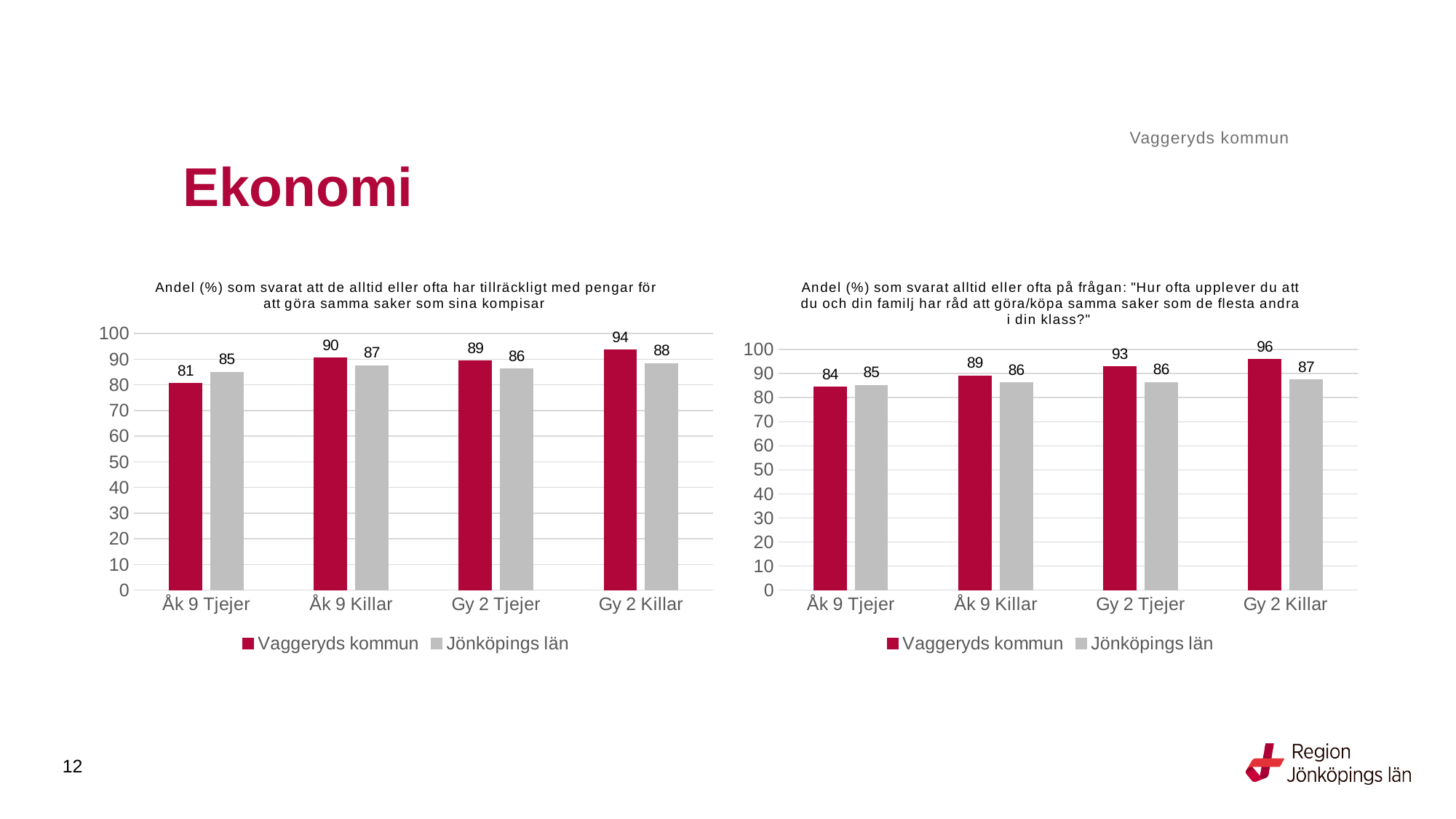
In the left chart, what is the difference between Vaggeryds kommun and Jönköpings län for Gy 2 Killar? 6 In the right chart, what is the value for Jönköpings län for Åk 9 Killar? 86 In the left chart, which category has the highest value for Vaggeryds kommun? Gy 2 Killar In the right chart, what is the value for Vaggeryds kommun for Gy 2 Tjejer? 93 In the left chart, which is larger for Åk 9 Tjejer: Vaggeryds kommun or Jönköpings län? Jönköpings län How many categories are shown on the x axis of the right chart? 4 In the right chart, what is the difference between Vaggeryds kommun and Jönköpings län for Gy 2 Killar? 9 In the left chart, what is the value for Jönköpings län for Gy 2 Killar? 88 In the left chart, what is the value for Vaggeryds kommun for Åk 9 Tjejer? 81 In the right chart, which category has the lowest value for Vaggeryds kommun? Åk 9 Tjejer What kind of chart is the right chart? Bar chart How many series does the legend of the left chart list? 2